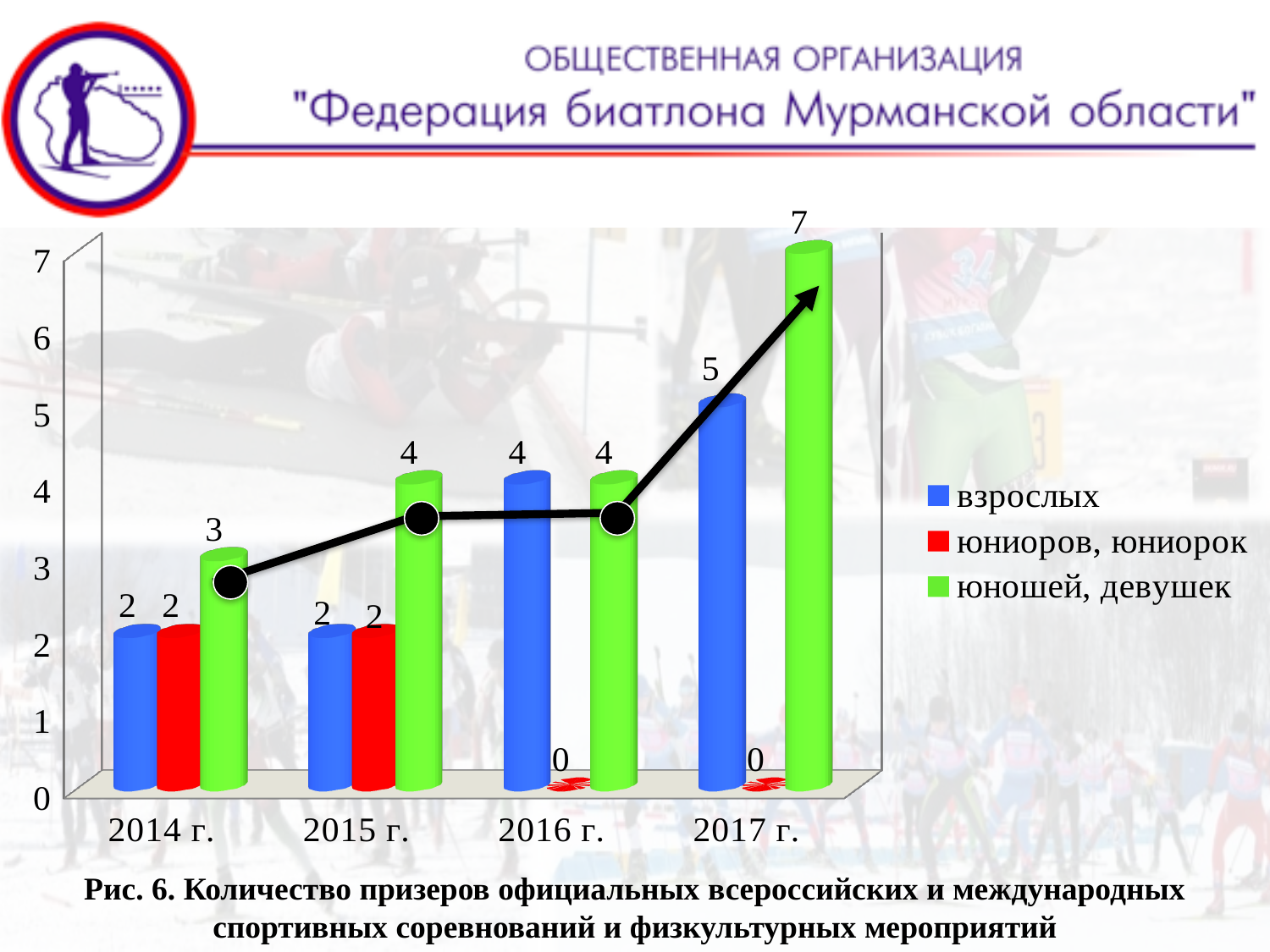
What kind of chart is shown on the slide? Bar chart How many series does the legend list? 3 Does the value for "юношей, девушек" rise or fall from 2014 г. to 2017 г.? Rise How many years are shown on the x axis? 4 Which is larger in 2017 г.: "взрослых" or "юношей, девушек"? юношей, девушек In which year is the value for "юношей, девушек" highest? 2017 г. What is the value for "юношей, девушек" in 2017 г.? 7 What is the value for "юниоров, юниорок" in 2015 г.? 2 What is the value for "юниоров, юниорок" in 2017 г.? 0 What is the value for "взрослых" in 2016 г.? 4 What is the difference between the "юношей, девушек" values in 2017 г. and 2016 г.? 3 In which year is the value for "взрослых" lowest? 2014 г. and 2015 г. (both 2)